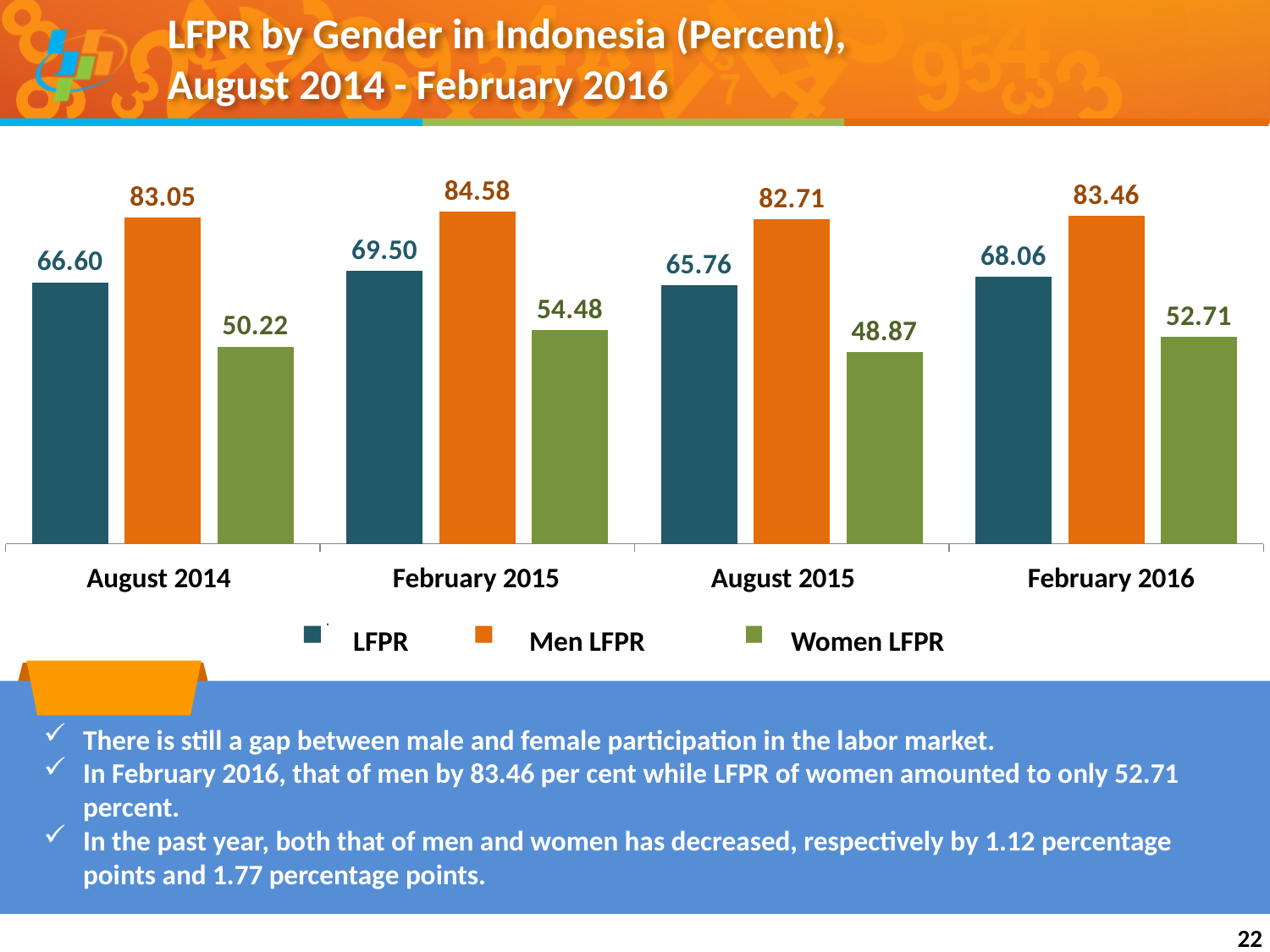
What is the Men LFPR value for February 2016? 83.46 Which is larger, the LFPR in August 2014 or the LFPR in February 2016? February 2016 What kind of chart is shown on the slide? Bar chart How many periods are shown on the x axis? 4 Which colour represents Men LFPR in the legend? Orange How many series does the legend list? 3 In which period is the Men LFPR highest? February 2015 What is the LFPR value for February 2015? 69.50 In which period is the Women LFPR lowest? August 2015 What is the difference between Men LFPR and Women LFPR in February 2016? 30.75 Does the Women LFPR rise or fall from February 2015 to August 2015? Fall What is the Women LFPR value for August 2015? 48.87